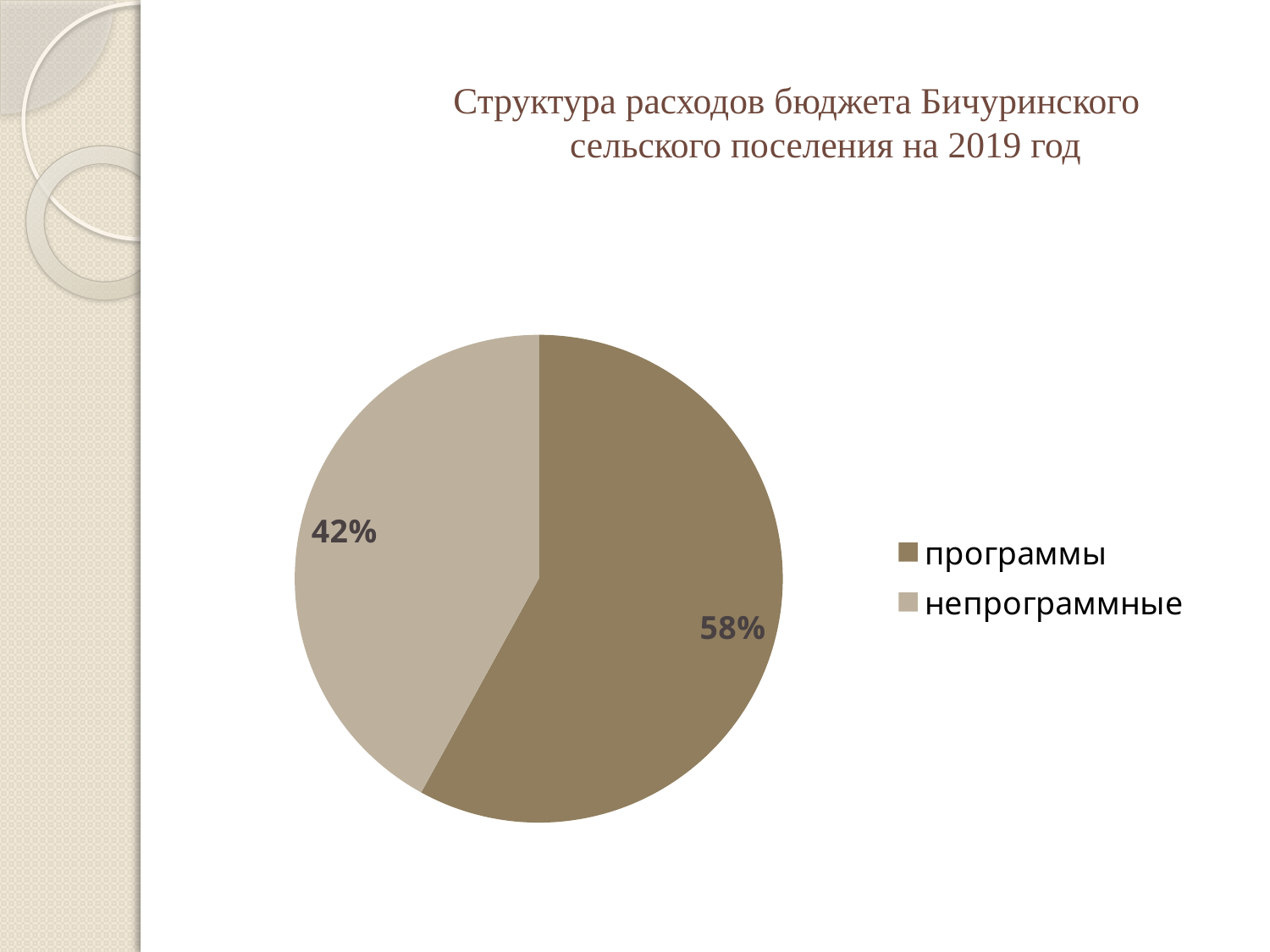
Which legend entry is shown in the darker brown colour? программы Which category has the largest slice of the pie? программы How many slices does the pie chart have? 2 What is the title of the chart on the slide? Структура расходов бюджета Бичуринского сельского поселения на 2019 год Which category has the smallest slice of the pie? непрограммные What share of the pie does the 'непрограммные' slice represent? 42% What share of the pie does the 'программы' slice represent? 58% How many entries does the legend list? 2 Which is larger, the 'программы' slice or the 'непрограммные' slice? программы What is the difference in percentage points between the 'программы' and 'непрограммные' slices? 16% What kind of chart is shown on the slide? pie chart